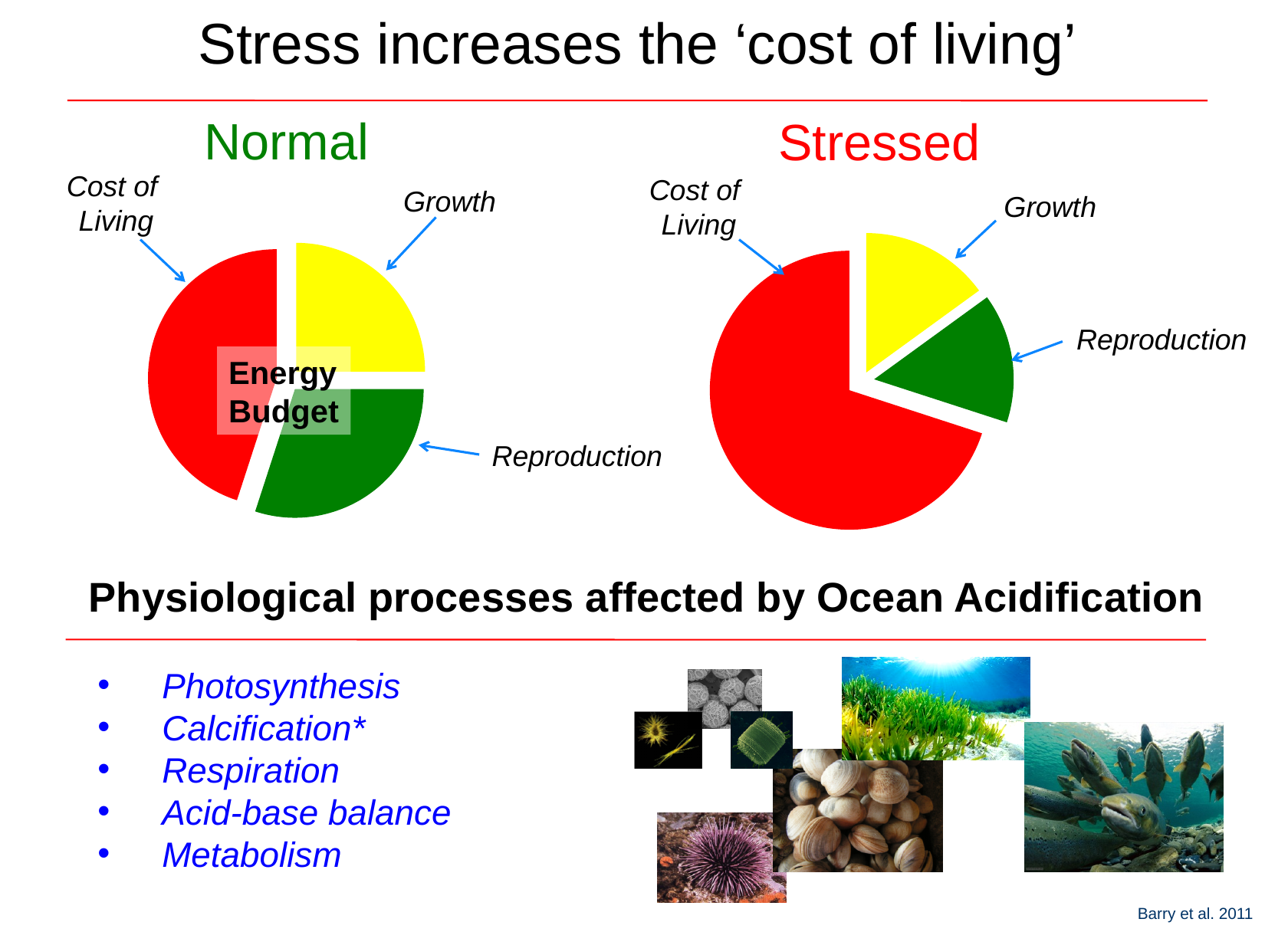
In the Normal chart, which slice is the largest? Cost of Living Is the Growth slice larger in the Normal chart or in the Stressed chart? Normal How many slices does the Stressed pie chart have? 3 What kind of chart is the Stressed chart? pie chart What colour is the Growth slice in both pie charts? yellow How many slices does the Normal pie chart have? 3 What kind of chart is the Normal chart? pie chart Is the Cost of Living slice larger in the Normal chart or in the Stressed chart? Stressed In the Normal chart, which is larger, the Cost of Living slice or the Growth slice? Cost of Living What label is printed in the centre of the Normal pie chart? Energy Budget In the Stressed chart, which slice is the largest? Cost of Living